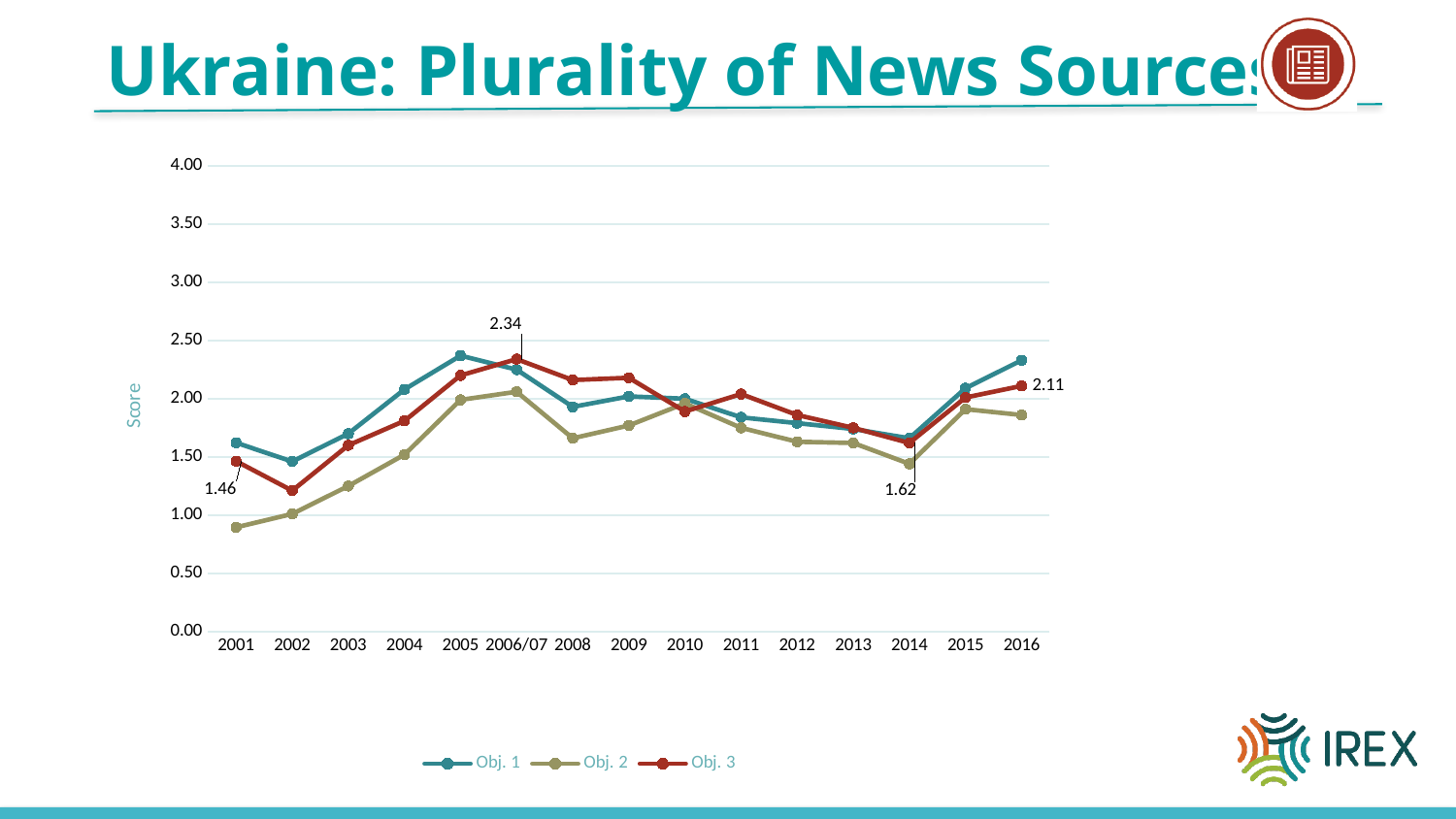
In which year does Obj. 3 reach its highest value? 2006/07 What is the difference between the Obj. 3 values in 2006/07 and 2001? 0.88 What is the title of the y axis? Score What is the value for Obj. 3 in 2001? 1.46 Which series has the higher value in 2001, Obj. 1 or Obj. 2? Obj. 1 Is the value for Obj. 2 in 2001 greater or less than 1.00? less What is the value for Obj. 3 in 2006/07? 2.34 How many points are plotted along the x axis? 15 What is the value for Obj. 3 in 2016? 2.11 What kind of chart is shown on the slide? line chart How many series does the legend list? 3 What is the value for Obj. 3 in 2014? 1.62